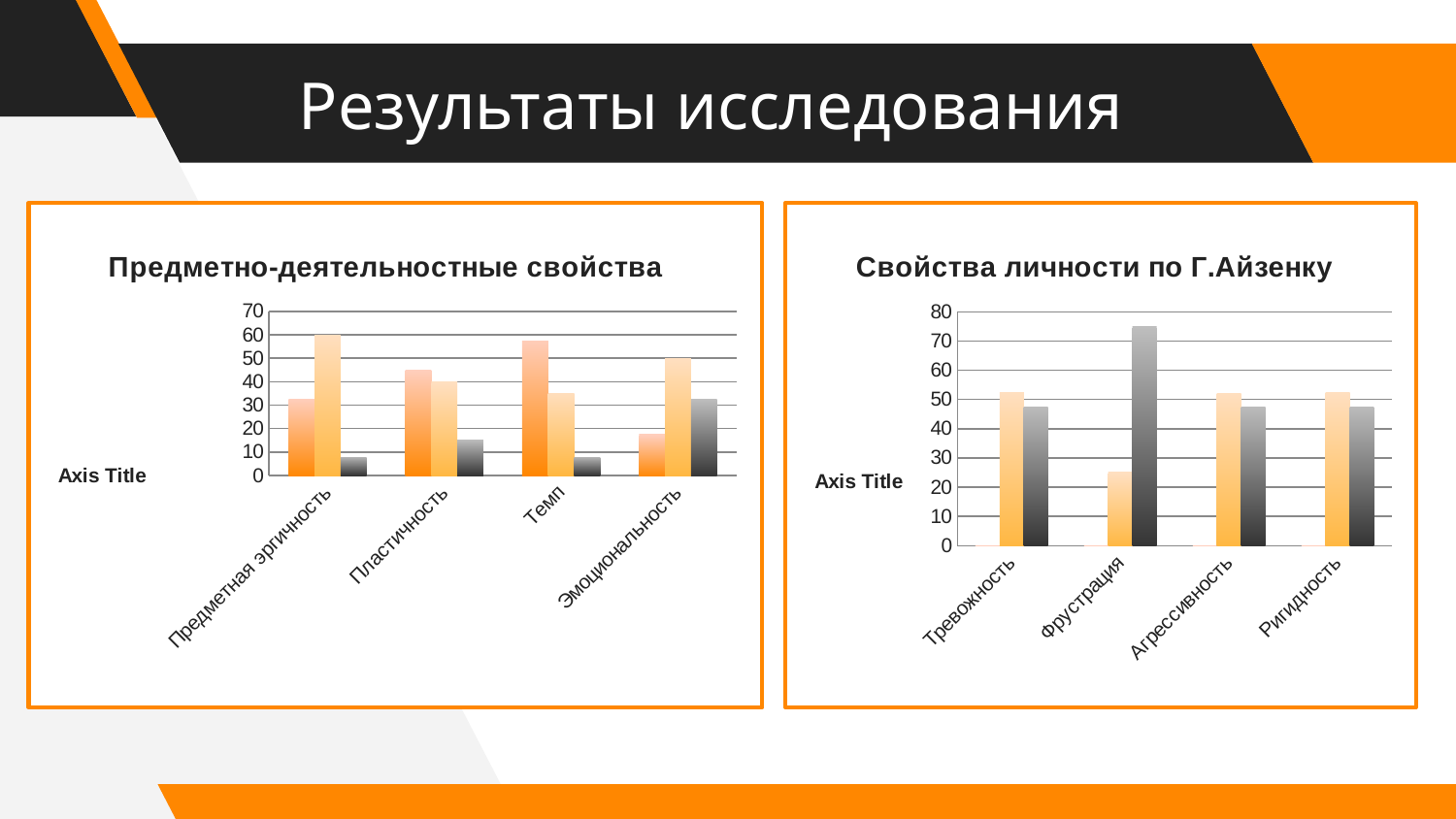
In the 'Предметно-деятельностные свойства' chart, is the light orange bar for Предметная эргичность greater or less than 50? greater In the 'Свойства личности по Г.Айзенку' chart, which category has the tallest bar? Фрустрация What kind of chart is the 'Предметно-деятельностные свойства' chart? bar chart What is the title of the chart on the left side of the slide? Предметно-деятельностные свойства In the 'Свойства личности по Г.Айзенку' chart, is the dark gray bar for Тревожность greater or less than 40? greater In the 'Свойства личности по Г.Айзенку' chart, is the dark gray bar for Фрустрация greater or less than 70? greater In the 'Предметно-деятельностные свойства' chart, which category has the highest dark gray bar? Эмоциональность In the 'Предметно-деятельностные свойства' chart, which category has the lowest orange (first) bar? Эмоциональность How many categories are shown on the x axis of the 'Свойства личности по Г.Айзенку' chart? 4 How many categories are shown on the x axis of the 'Предметно-деятельностные свойства' chart? 4 In the 'Свойства личности по Г.Айзенку' chart, for Фрустрация, which bar is larger: the light orange bar or the dark gray bar? the dark gray bar